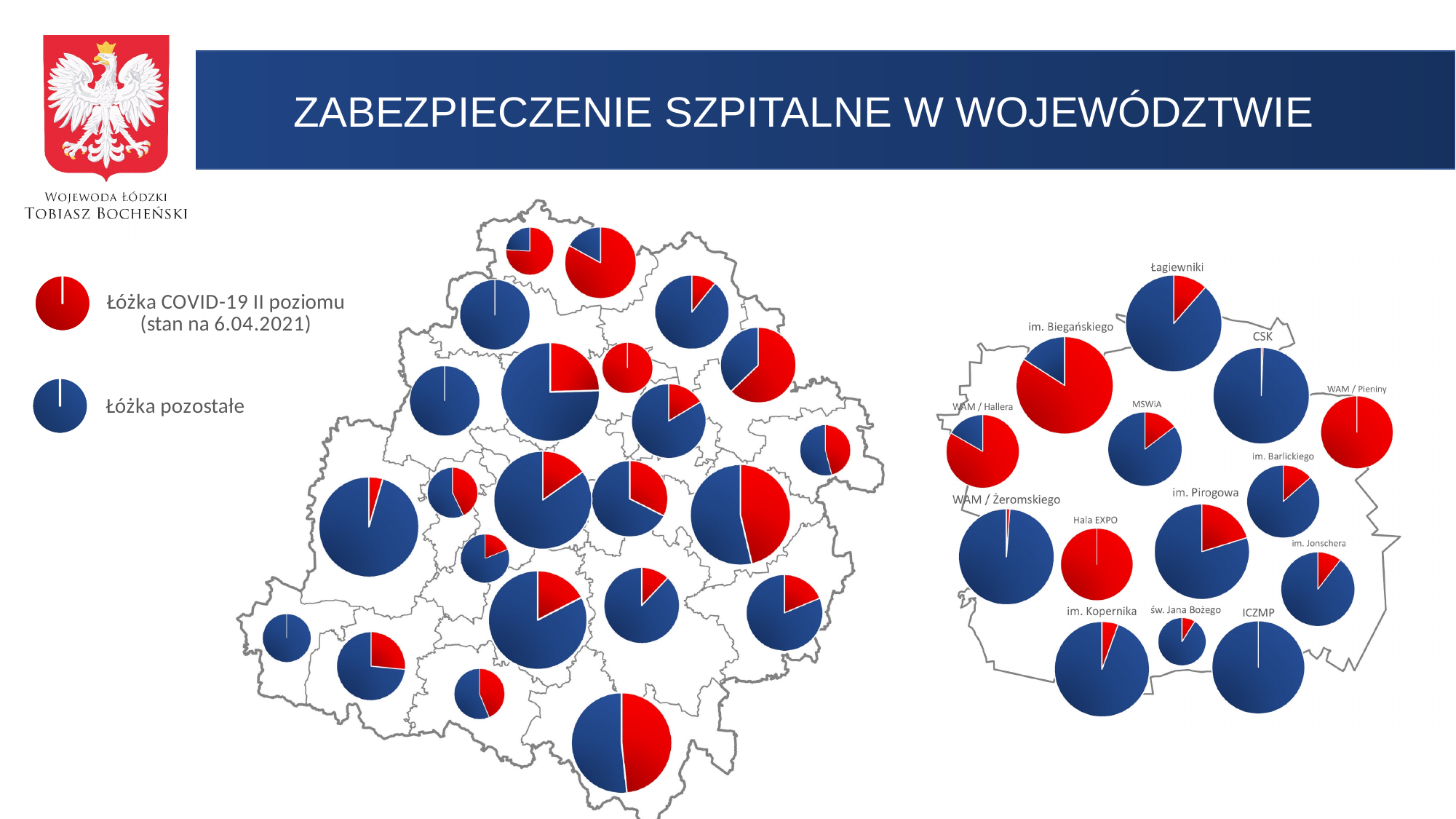
On the right-hand map, which has the larger share of COVID-19 beds (red): im. Pirogowa or im. Kopernika? im. Pirogowa On the right-hand map, how many labelled hospital pies are shown? 14 On the right-hand map, which has the larger share of COVID-19 beds (red): WAM / Pieniny or im. Barlickiego? WAM / Pieniny Which colour in the pies represents 'Łóżka COVID-19 II poziomu'? red On the right-hand map, which has the larger share of COVID-19 beds (red): WAM / Hallera or im. Jonschera? WAM / Hallera What is the title of the slide containing the pie chart maps? ZABEZPIECZENIE SZPITALNE W WOJEWÓDZTWIE What kind of chart is used to show the hospital bed data on the maps? pie chart How many entries does the legend on the left list? 2